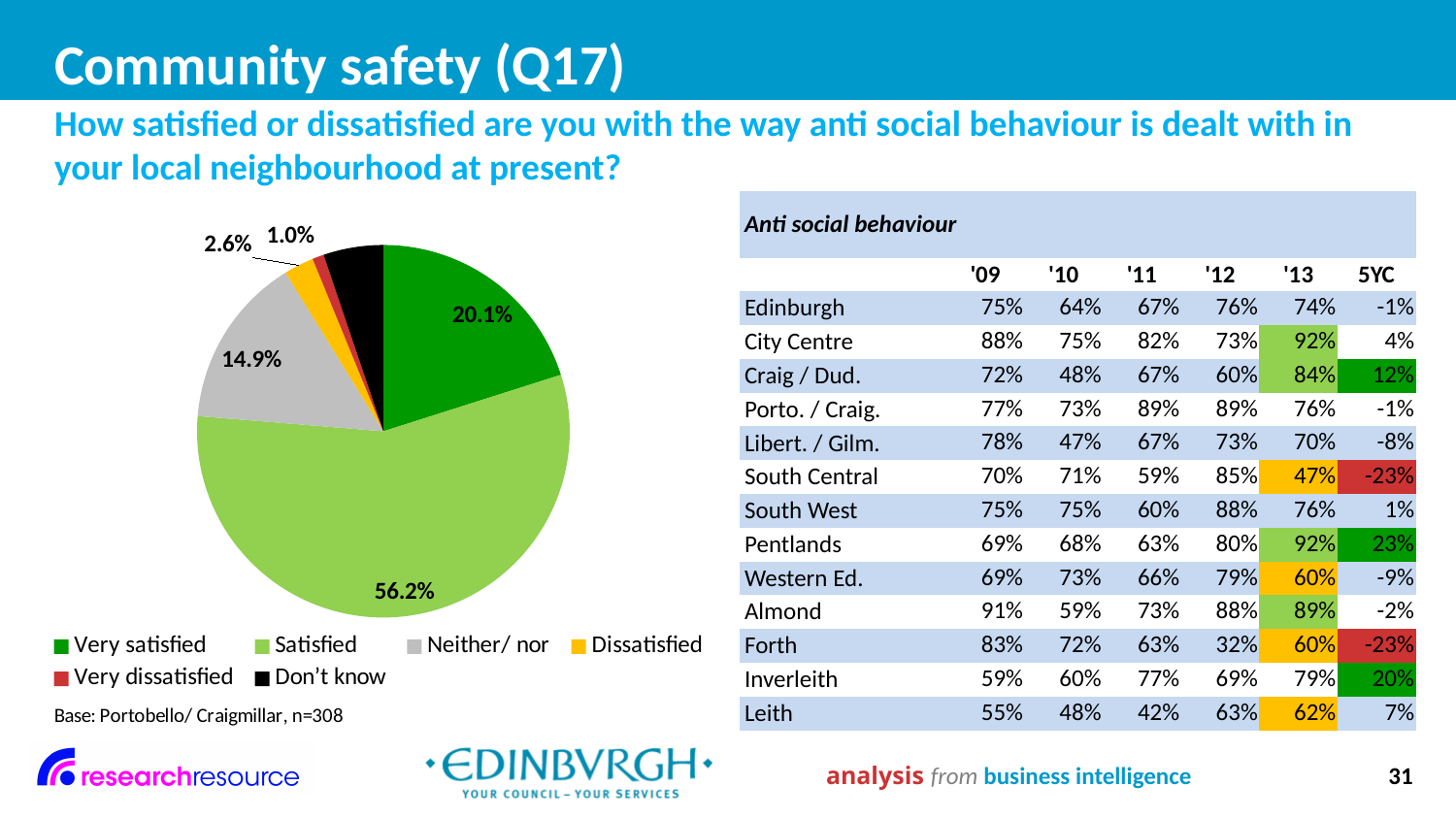
Which category has the largest share of the pie chart? Satisfied What percentage of respondents are 'Very dissatisfied' in the pie chart? 1.0% What is the base (sample size) stated below the pie chart? Portobello/ Craigmillar, n=308 Which is larger in the pie chart: 'Neither/ nor' or 'Very satisfied'? Very satisfied What percentage of respondents are 'Satisfied' in the pie chart? 56.2% What kind of chart is shown on the slide? pie chart Which category has the smallest share of the pie chart? Very dissatisfied What is the difference between the 'Satisfied' and 'Very satisfied' shares in the pie chart? 36.1% How many categories does the legend of the pie chart list? 6 What percentage of respondents are 'Dissatisfied' in the pie chart? 2.6% What percentage of respondents answered 'Neither/ nor' in the pie chart? 14.9% What percentage of respondents are 'Very satisfied' in the pie chart? 20.1%